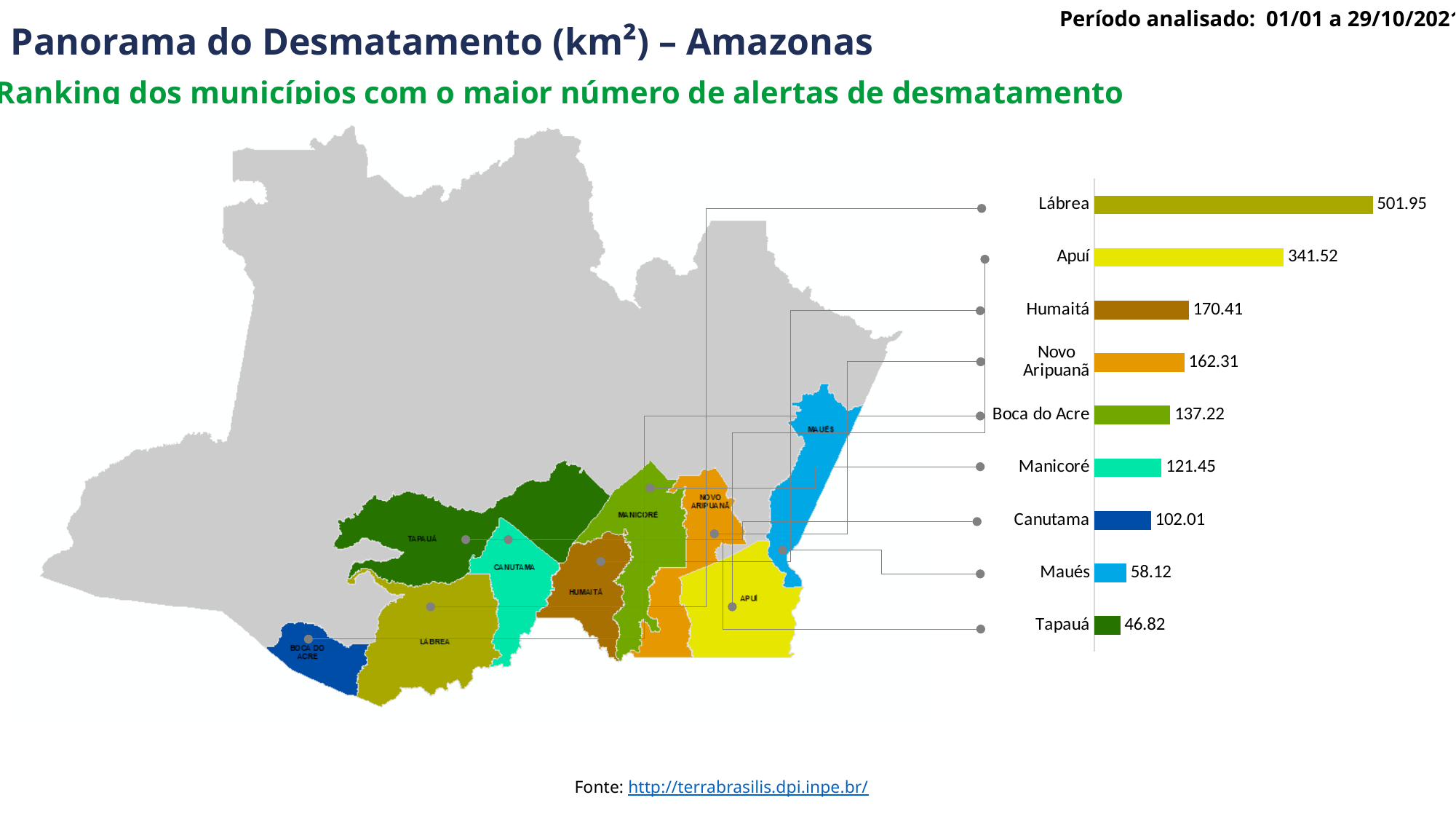
What is the difference between the values for Lábrea and Apuí? 160.43 Which municipality has the highest value? Lábrea What is the value for Novo Aripuanã? 162.31 Which municipality has the lowest value? Tapauá What is the value for Lábrea? 501.95 How many municipalities are shown in the bar chart? 9 What is the value for Apuí? 341.52 Which has a larger value, Manicoré or Canutama? Manicoré What is the difference between the values for Humaitá and Novo Aripuanã? 8.1 What kind of chart is used to show the ranking? Bar chart What colour is the bar for Maués? Light blue What is the value for Maués? 58.12